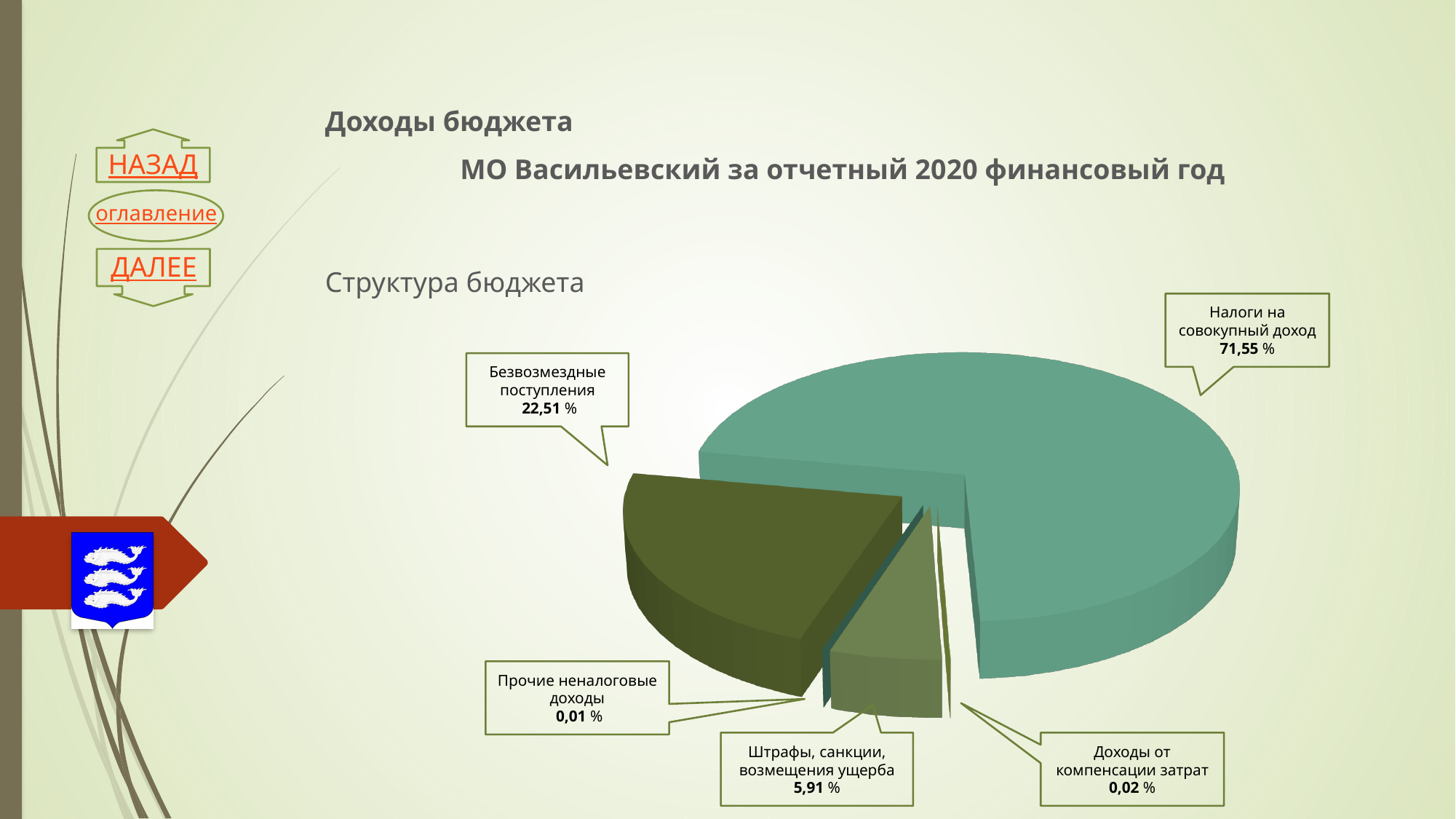
Which category has the smallest share of the pie? Прочие неналоговые доходы What share is shown for Безвозмездные поступления? 22,51 % What share of the budget is labelled for Налоги на совокупный доход? 71,55 % Which is larger: the share for Безвозмездные поступления or for Штрафы, санкции, возмещения ущерба? Безвозмездные поступления What share is shown for Доходы от компенсации затрат? 0,02 % How many slices does the pie chart have? 5 What is the difference in percentage points between Налоги на совокупный доход and Безвозмездные поступления? 49,04 What share is shown for Прочие неналоговые доходы? 0,01 % What kind of chart is shown on the slide? pie chart What share is shown for Штрафы, санкции, возмещения ущерба? 5,91 % Which category has the largest share of the pie? Налоги на совокупный доход What is the heading shown above the pie chart? Структура бюджета